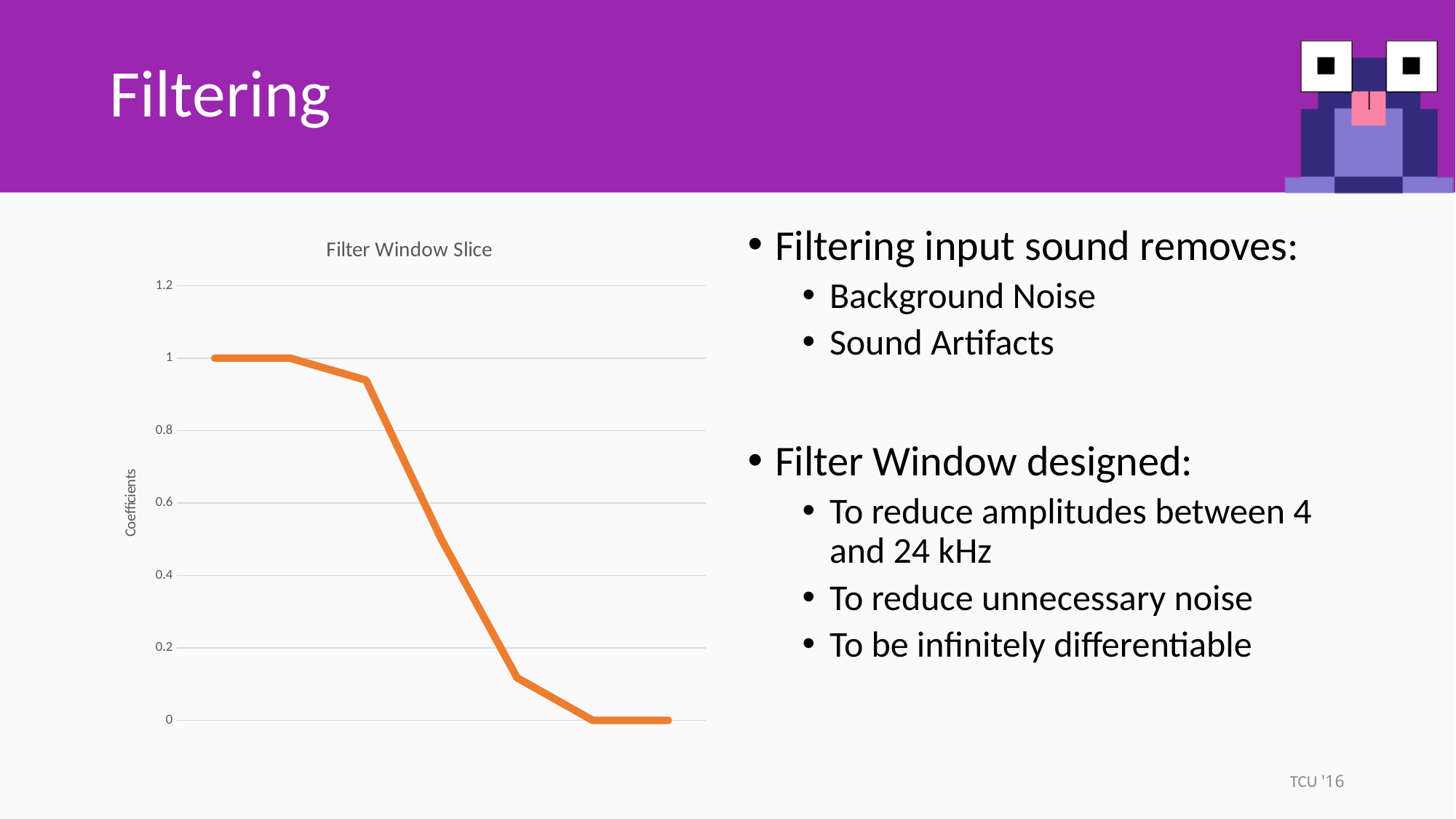
Is the value of the fourth point from the left greater or less than 0.2? greater Is the value of the third point from the left greater or less than 0.8? greater What is the value of the leftmost point on the line? 1 What is the highest value reached by the line? 1 What is the label on the vertical axis of the chart? Coefficients What is the title of the chart? Filter Window Slice What is the lowest value reached by the line? 0 What is the highest tick value shown on the vertical axis? 1.2 Which is larger, the value of the leftmost point or the value of the rightmost point? the leftmost point What is the value of the rightmost point on the line? 0 Do the values in the chart rise or fall from left to right? fall What kind of chart is shown on the slide? line chart